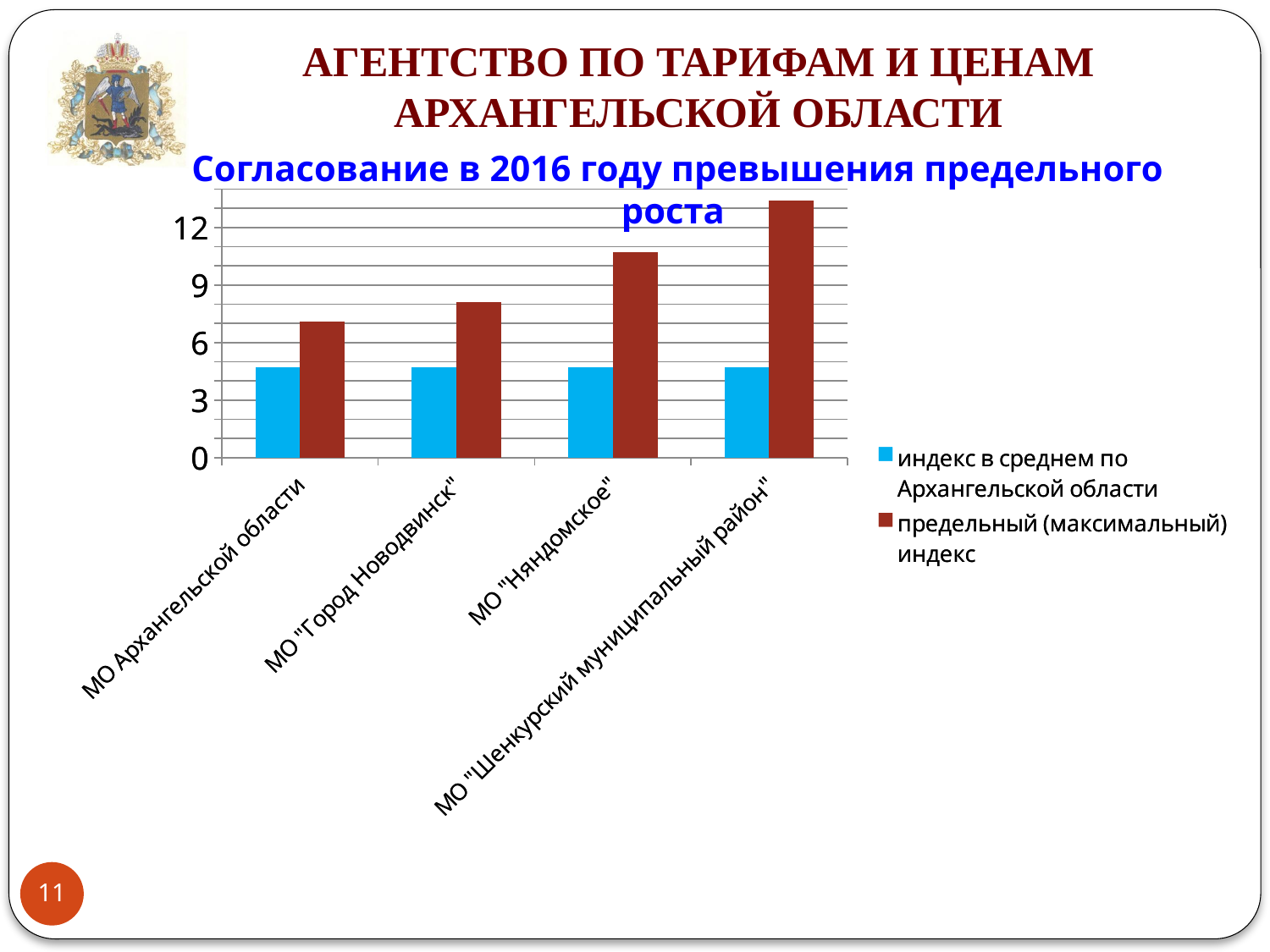
Do the values of "предельный (максимальный) индекс" rise or fall from left to right along the x axis? rise What kind of chart is shown on the slide? bar chart Is the value of "предельный (максимальный) индекс" for МО "Шенкурский муниципальный район" greater or less than 12? greater Is the value of "предельный (максимальный) индекс" for МО "Няндомское" greater or less than 9? greater Which category has the highest value for the series "предельный (максимальный) индекс"? МО "Шенкурский муниципальный район" Which category has the lowest value for the series "предельный (максимальный) индекс"? МО Архангельской области Is the value of "предельный (максимальный) индекс" for МО "Город Новодвинск" greater or less than 9? less For МО "Город Новодвинск", which series has the larger value: "индекс в среднем по Архангельской области" or "предельный (максимальный) индекс"? предельный (максимальный) индекс What colour are the bars for the series "индекс в среднем по Архангельской области"? blue How many categories are shown on the x axis of the chart? 4 How many series does the chart legend list? 2